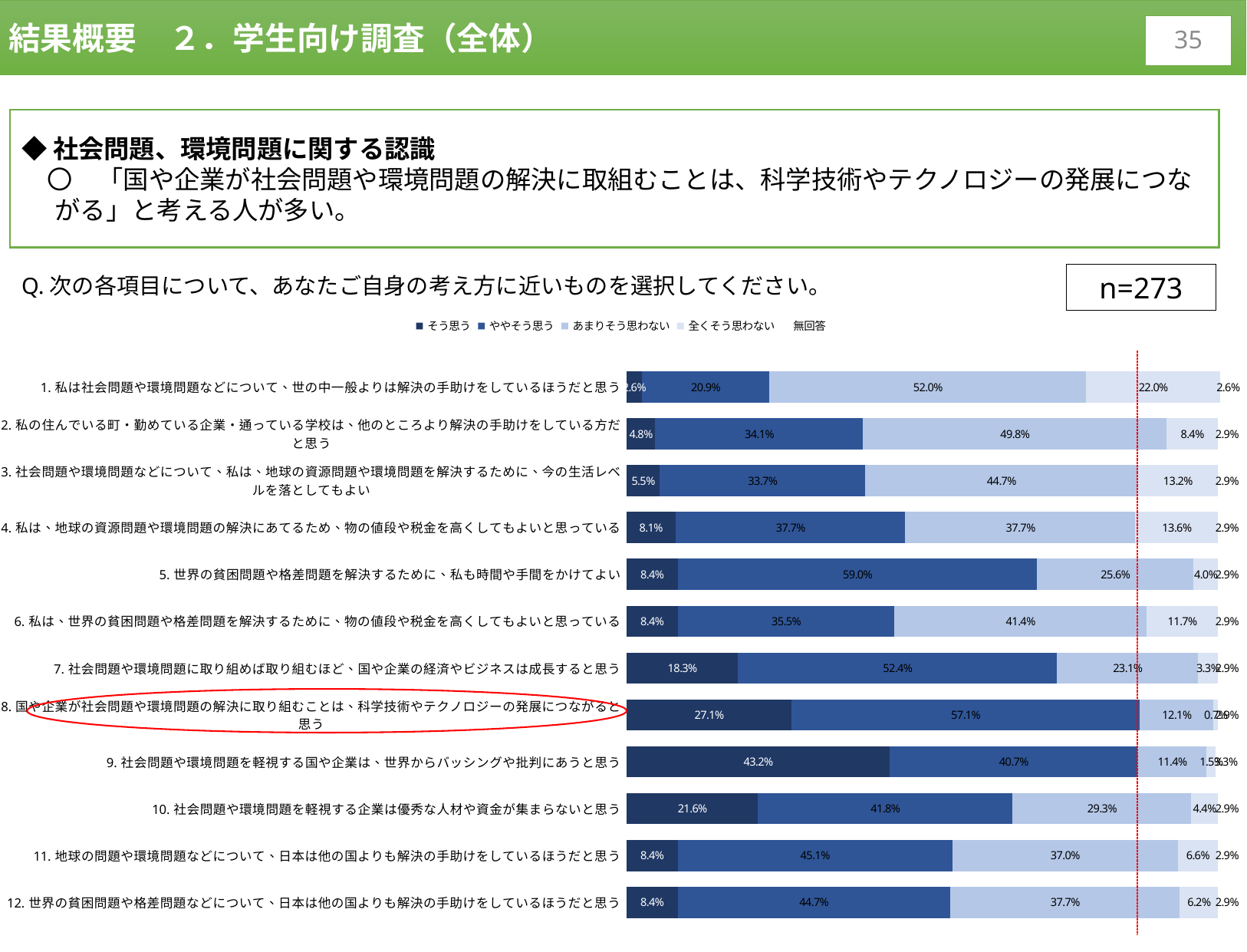
Which statement has the highest 「そう思う」 value? 9. 社会問題や環境問題を軽視する国や企業は、世界からバッシングや批判にあうと思う Which statement has the lowest 「そう思う」 value? 1. 私は社会問題や環境問題などについて、世の中一般よりは解決の手助けをしているほうだと思う What is the difference between the 「ややそう思う」 values for statement 5 (59.0%) and statement 6 (35.5%)? 23.5% What is the combined share of 「そう思う」 and 「ややそう思う」 for statement 5 (世界の貧困問題や格差問題を解決するために、私も時間や手間をかけてよい)? 67.4% What is the 「そう思う」 value for statement 9 (社会問題や環境問題を軽視する国や企業は、世界からバッシングや批判にあうと思う)? 43.2% How many statements (categories) are plotted in the chart? 12 What is the 「あまりそう思わない」 value for statement 1 (私は社会問題や環境問題などについて、世の中一般よりは解決の手助けをしているほうだと思う)? 52.0% What is the 「ややそう思う」 value for statement 8 (国や企業が社会問題や環境問題の解決に取り組むことは、科学技術やテクノロジーの発展につながると思う)? 57.1% Which is larger: the 「そう思う」 value for statement 7 or for statement 10? Statement 10 (21.6%) What is the sample size (n) shown for this survey chart? n=273 How many series does the chart legend list? 5 What type of chart is shown on the slide? Stacked bar chart